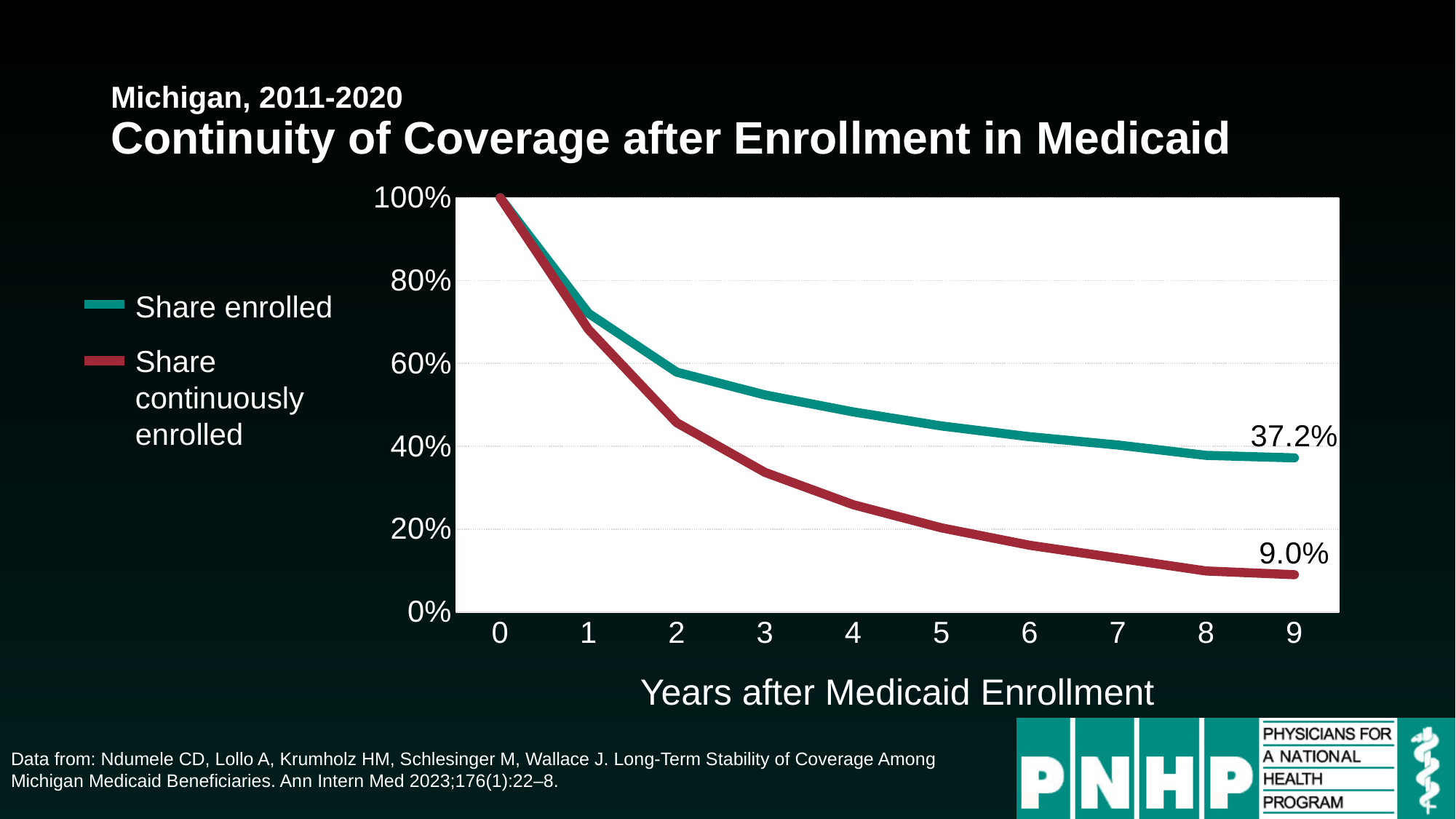
How many year points are plotted along the x axis? 10 What is the value of Share continuously enrolled at year 9 after Medicaid enrollment? 9.0% Is the value for Share enrolled at year 1 greater or less than 60%? greater What is the difference between Share enrolled and Share continuously enrolled at year 9? 28.2 percentage points What is the value of Share enrolled at year 9 after Medicaid enrollment? 37.2% What is the value of both series at year 0? 100% How many series does the legend list? 2 What kind of chart is shown on the slide? Line chart At year 9, which series has the larger value, Share enrolled or Share continuously enrolled? Share enrolled What is the label of the x axis? Years after Medicaid Enrollment Do the values of Share continuously enrolled rise or fall as years after enrollment increase? Fall Is the value for Share continuously enrolled at year 2 greater or less than 40%? greater